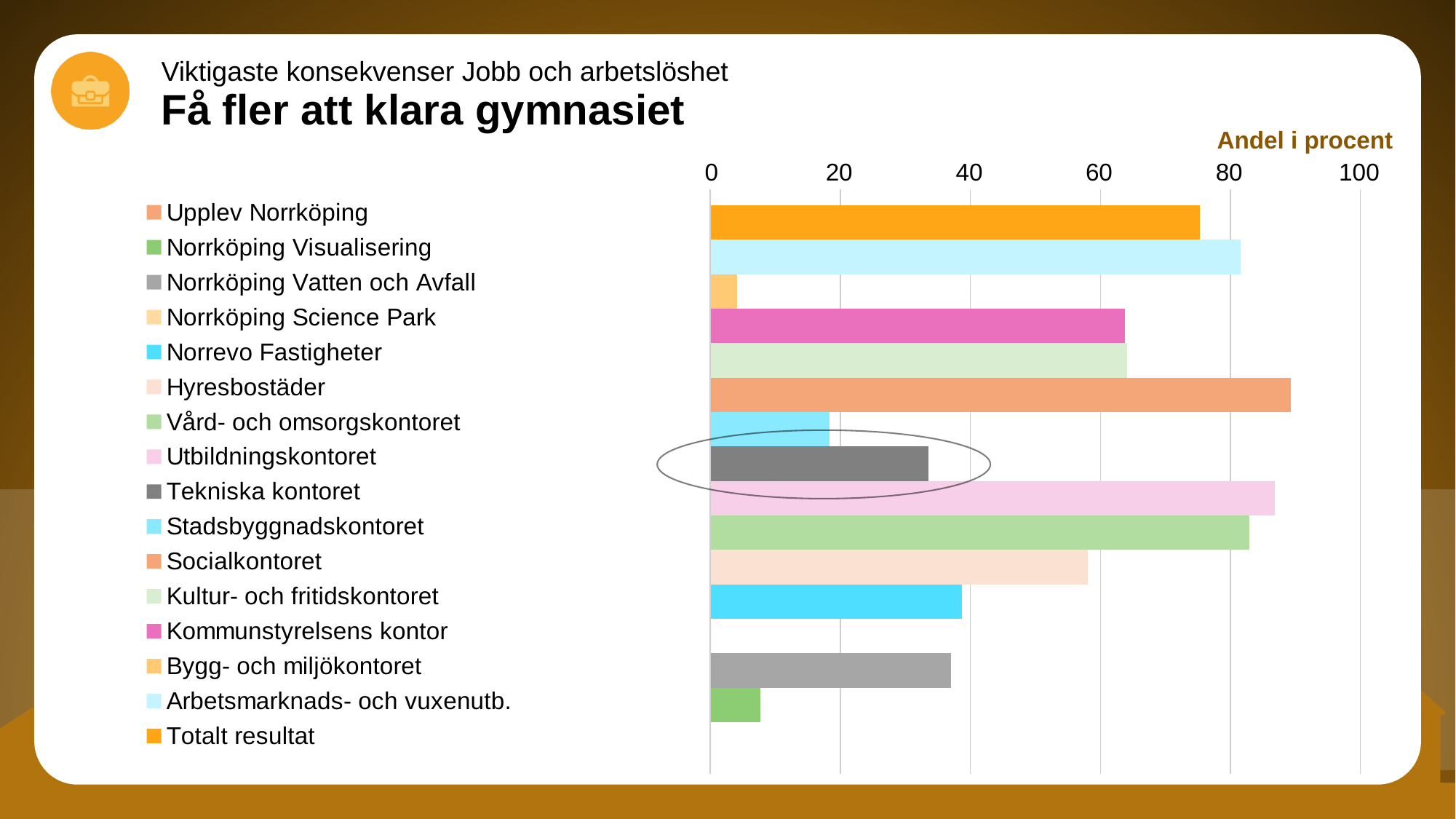
Is the value for Bygg- och miljökontoret greater or less than 20? less What is the axis title shown above the chart's horizontal axis? Andel i procent Is the value for Utbildningskontoret greater or less than 80? greater Which is larger, the value for Tekniska kontoret or the value for Utbildningskontoret? Utbildningskontoret Is the value for Tekniska kontoret greater or less than 40? less How many entries does the chart legend list? 16 Which is larger, the value for Socialkontoret or the value for Stadsbyggnadskontoret? Socialkontoret Which bar in the chart is circled? Tekniska kontoret What kind of chart is shown on the slide? bar chart